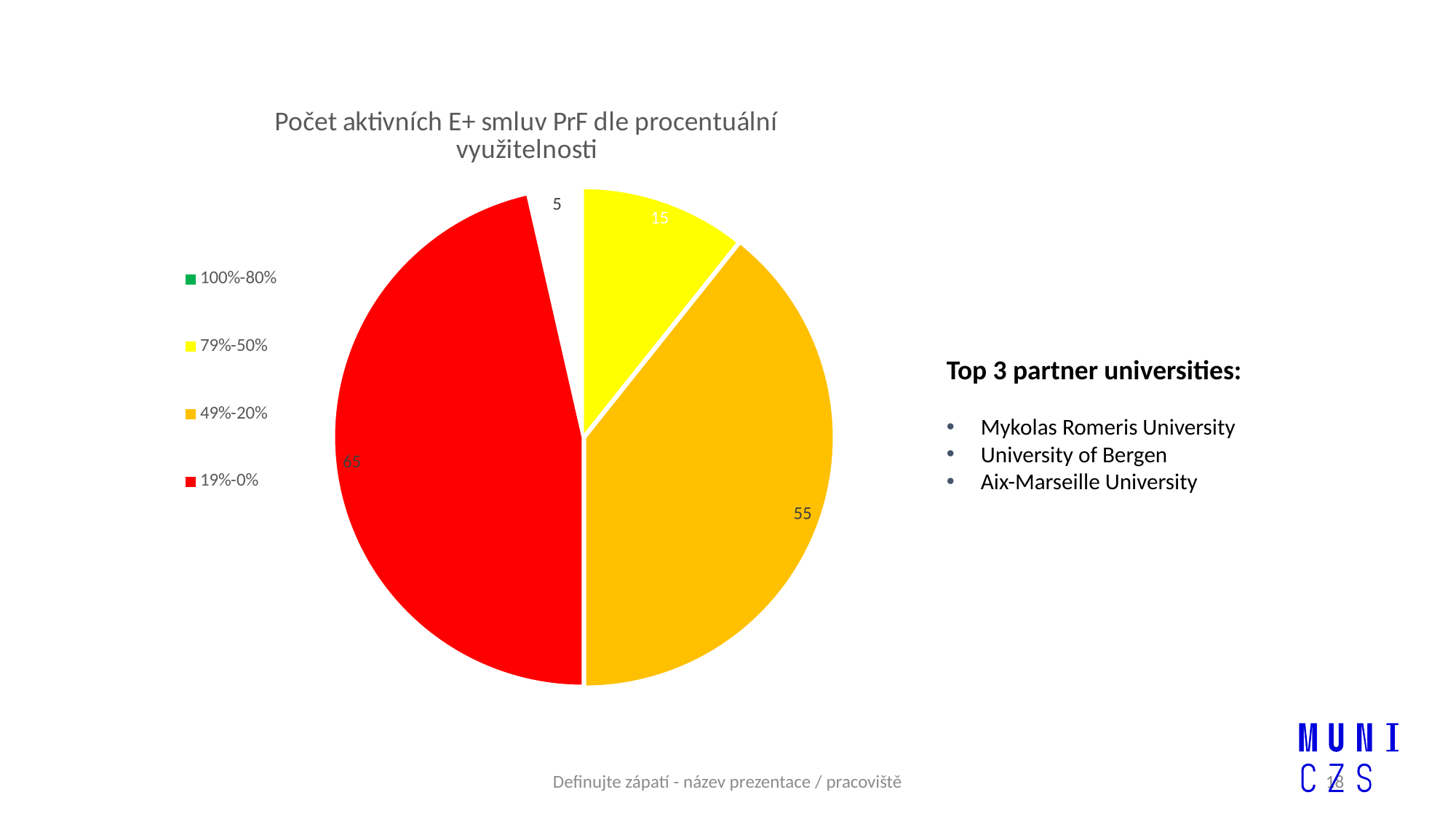
What is the value of the 49%-20% slice in the pie chart? 55 Which category has the largest slice in the pie chart? 19%-0% What is the difference between the 19%-0% slice and the 49%-20% slice? 10 What is the difference between the 49%-20% slice and the 79%-50% slice? 40 What is the value of the 79%-50% slice in the pie chart? 15 What type of chart is shown on the slide? Pie chart Which is larger, the 79%-50% slice or the 100%-80% slice? 79%-50% What is the value of the 19%-0% slice in the pie chart? 65 What is the total of all slices in the pie chart? 140